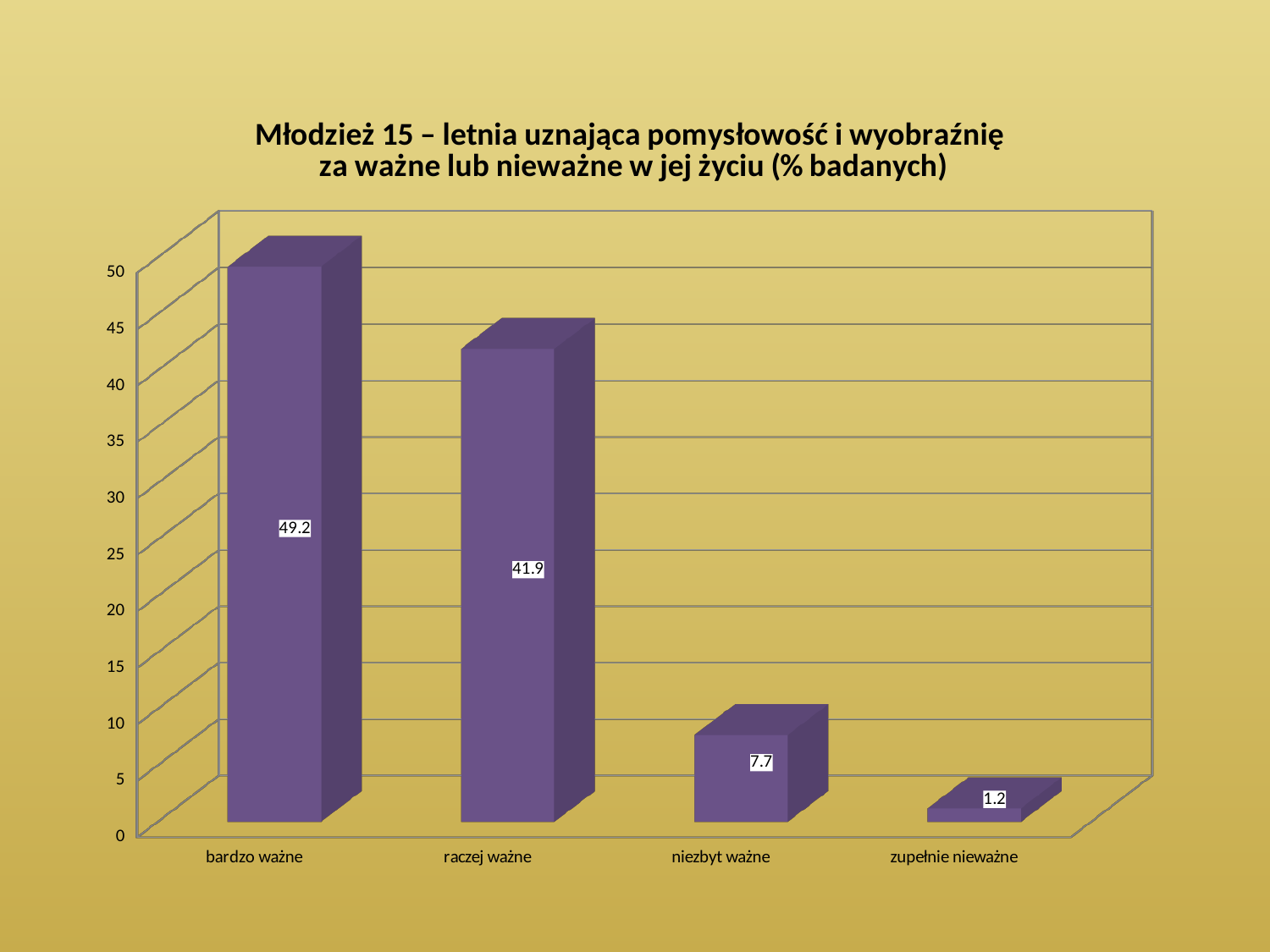
Is the value for "raczej ważne" greater or less than 40? greater What is the difference between the values for "bardzo ważne" and "raczej ważne"? 7.3 What is the value for "raczej ważne"? 41.9 What is the value for "niezbyt ważne"? 7.7 Which category has the highest value? bardzo ważne How many categories are shown on the x axis? 4 Do the values rise or fall from left to right along the x axis? fall Which category has the lowest value? zupełnie nieważne Which is larger, the value for "niezbyt ważne" or "zupełnie nieważne"? niezbyt ważne What is the value for "bardzo ważne"? 49.2 What kind of chart is shown on the slide? bar chart What is the value for "zupełnie nieważne"? 1.2